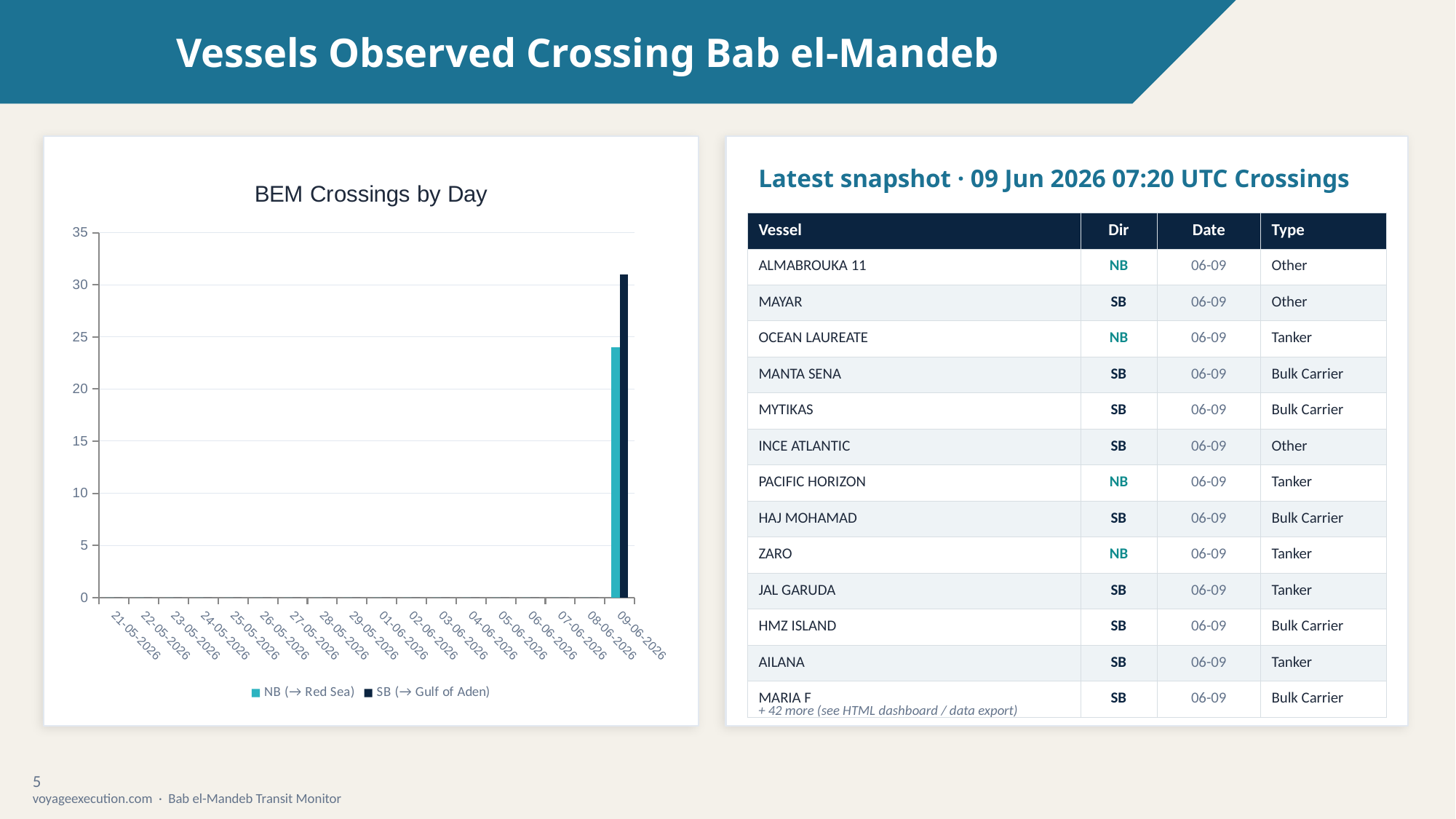
In 'BEM Crossings by Day', is the SB (→ Gulf of Aden) value for 09-06-2026 greater or less than 35? less In 'BEM Crossings by Day', is the NB (→ Red Sea) value for 09-06-2026 greater or less than 25? less What is the highest value shown on the y axis of 'BEM Crossings by Day'? 35 What kind of chart is 'BEM Crossings by Day'? bar chart In 'BEM Crossings by Day', is the SB (→ Gulf of Aden) value for 09-06-2026 greater or less than 30? greater What are the two series named in the legend of 'BEM Crossings by Day'? NB (→ Red Sea) and SB (→ Gulf of Aden) What is the first date shown on the x axis of 'BEM Crossings by Day'? 21-05-2026 How many series does the legend of 'BEM Crossings by Day' list? 2 How many dates are shown on the x axis of 'BEM Crossings by Day'? 18 In 'BEM Crossings by Day', which series has the larger value on 09-06-2026, NB (→ Red Sea) or SB (→ Gulf of Aden)? SB (→ Gulf of Aden) In 'BEM Crossings by Day', which date has the highest number of crossings? 09-06-2026